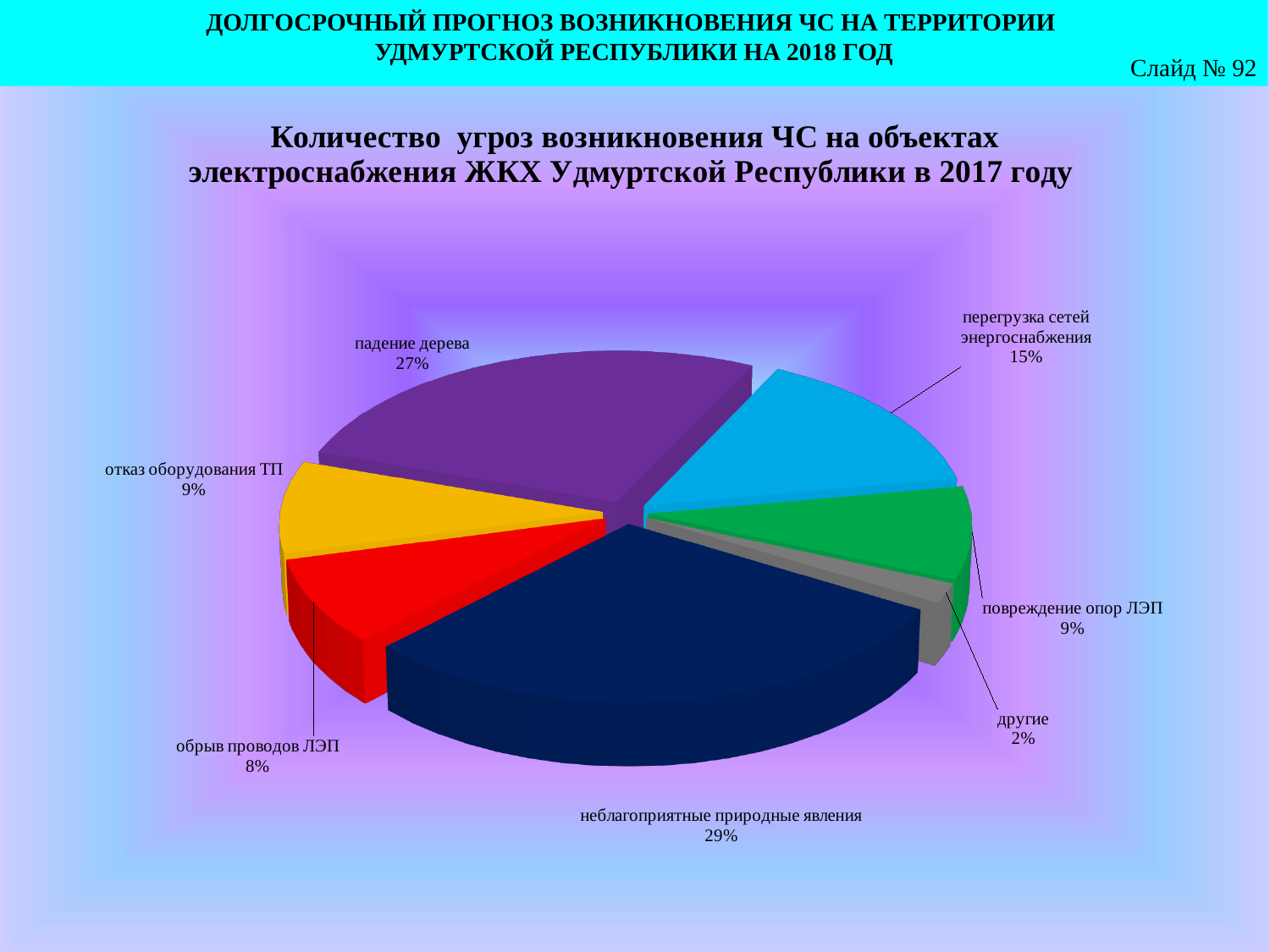
What kind of chart is shown on the slide? pie chart How many categories are shown in the pie chart? 7 What share of the pie does 'падение дерева' have? 27% What is the difference between the shares of 'неблагоприятные природные явления' and 'падение дерева'? 2% Which category has the largest slice of the pie? неблагоприятные природные явления Which is larger: the share for 'перегрузка сетей энергоснабжения' or the share for 'отказ оборудования ТП'? перегрузка сетей энергоснабжения What is the title of the chart? Количество угроз возникновения ЧС на объектах электроснабжения ЖКХ Удмуртской Республики в 2017 году Which category has the smallest slice of the pie? другие What is the value for 'обрыв проводов ЛЭП'? 8% What share of the pie does 'неблагоприятные природные явления' have? 29% What is the value for 'другие'? 2% What is the value for 'перегрузка сетей энергоснабжения'? 15%